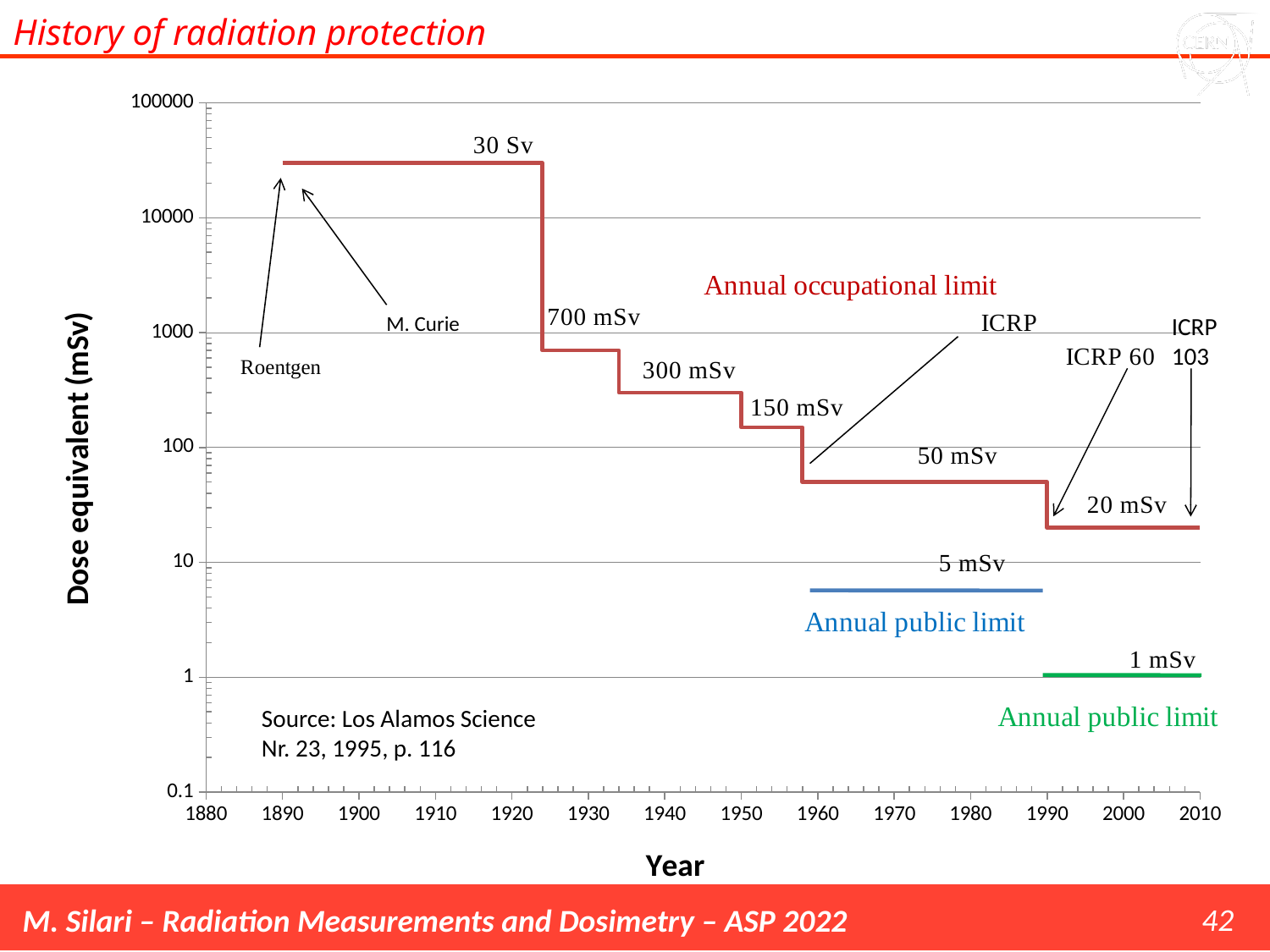
How many distinct annual occupational limit levels are labelled on the chart? 6 What is the annual occupational limit shown for the period starting around 1990? 20 mSv Is the annual occupational limit around 1940 greater or less than 100 mSv? greater By how much did the annual occupational limit drop from 50 mSv to 20 mSv? 30 mSv What is the difference between the 700 mSv and 300 mSv annual occupational limits? 400 mSv What is the earliest annual occupational limit value labelled on the chart, for the period from about 1890 to the mid-1920s? 30 Sv What is the label of the vertical axis? Dose equivalent (mSv) Does the annual occupational limit rise or fall over the years shown? fall What is the annual public limit shown by the blue line? 5 mSv What is the annual public limit shown by the green line? 1 mSv Which is larger, the annual public limit shown in blue or the one shown in green? The blue one (5 mSv) What annual occupational limit is labelled for the period from the mid-1930s to about 1950? 300 mSv